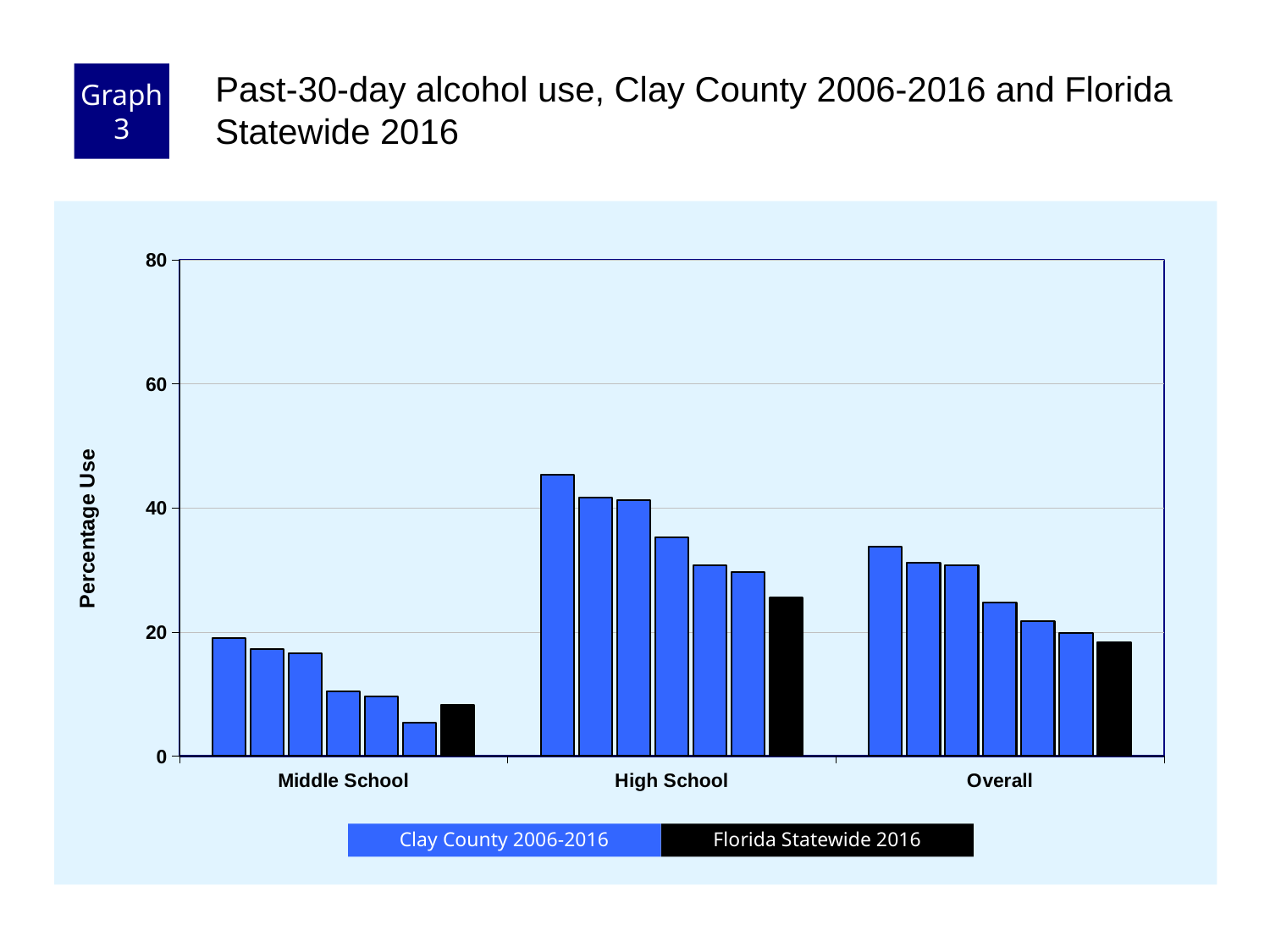
How many categories are shown along the x axis? 3 Is the tallest Clay County bar for High School greater or less than 40? greater What is the label on the y axis? Percentage Use Which category has the lowest bars overall? Middle School Is the Florida Statewide 2016 value for Middle School greater or less than 20? less Which is larger, the Florida Statewide 2016 value for High School or for Middle School? High School How many series does the legend list? 2 Which category has the highest bars overall? High School What kind of chart is shown on the slide? bar chart Is the tallest Clay County bar for Overall greater or less than 40? less Within each category, do the Clay County 2006-2016 bars generally rise or fall from left to right? fall